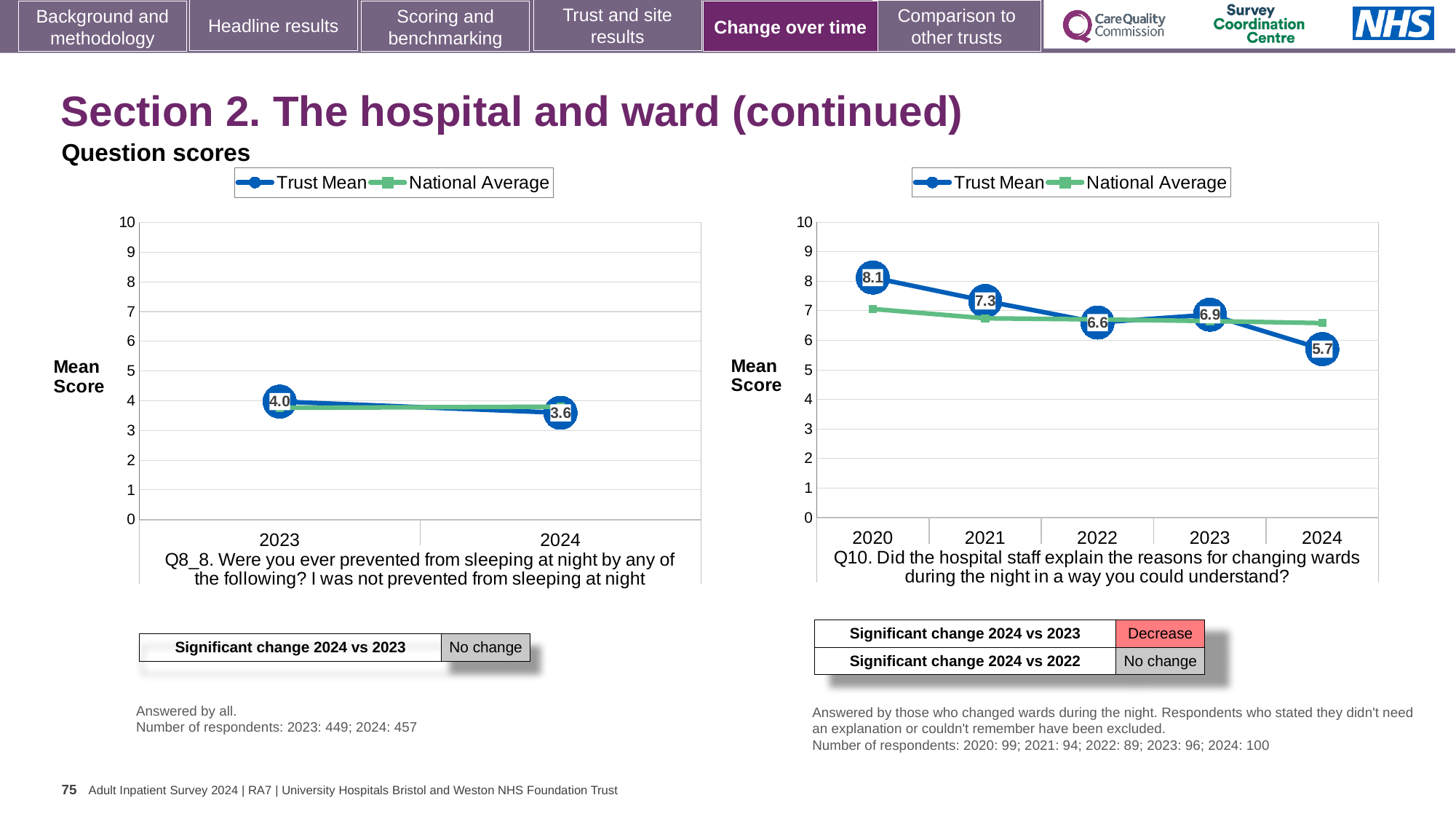
In the Q10 chart on the right, what is the Trust Mean score for 2024? 5.7 In the Q10 chart on the right, which year has the lowest Trust Mean score? 2024 In the Q8_8 chart on the left, what is the Trust Mean score for 2023? 4.0 What type of chart is the Q10 chart on the right? Line chart In the Q10 chart on the right, which year has the highest Trust Mean score? 2020 In the Q10 chart on the right, what is the Trust Mean score for 2020? 8.1 In the Q10 chart on the right, how many years are plotted on the x axis? 5 In the Q10 chart on the right, what is the difference between the Trust Mean scores for 2021 and 2022? 0.7 In the Q8_8 chart on the left, by how much did the Trust Mean fall from 2023 to 2024? 0.4 In the Q10 chart on the right, is the Trust Mean score for 2023 larger or smaller than for 2022? larger In the Q8_8 chart on the left, what is the Trust Mean score for 2024? 3.6 How many series does the legend of the Q8_8 chart on the left list? 2